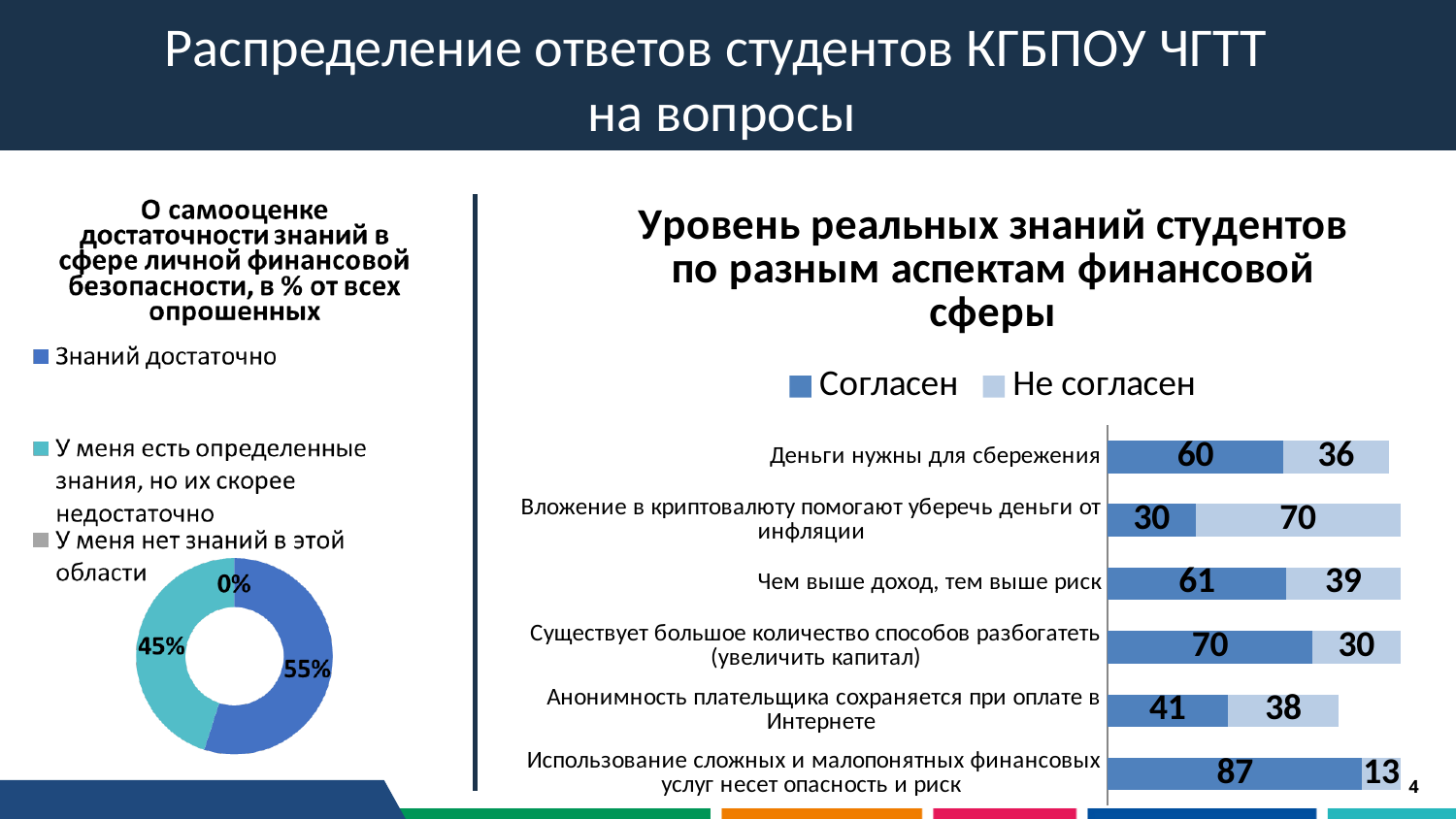
In the chart "Уровень реальных знаний студентов по разным аспектам финансовой сферы", which statement has the lowest "Согласен" value? Вложение в криптовалюту помогают уберечь деньги от инфляции In the chart "Уровень реальных знаний студентов по разным аспектам финансовой сферы", what is the difference between the "Согласен" and "Не согласен" values for "Деньги нужны для сбережения"? 24 How many series does the legend of the chart "Уровень реальных знаний студентов по разным аспектам финансовой сферы" list? 2 In the chart "Уровень реальных знаний студентов по разным аспектам финансовой сферы", what is the "Согласен" value for "Использование сложных и малопонятных финансовых услуг несет опасность и риск"? 87 In the donut chart on the left, what share of respondents answered "Знаний достаточно"? 55% In the donut chart on the left, what share of respondents answered "У меня нет знаний в этой области"? 0% What kind of chart is the chart on the left of the slide? Donut (pie) chart In the chart "Уровень реальных знаний студентов по разным аспектам финансовой сферы", which statement has the highest "Согласен" value? Использование сложных и малопонятных финансовых услуг несет опасность и риск In the donut chart on the left, which category has the largest share? Знаний достаточно How many statements (categories) are shown in the chart "Уровень реальных знаний студентов по разным аспектам финансовой сферы"? 6 In the chart "Уровень реальных знаний студентов по разным аспектам финансовой сферы", what is the "Не согласен" value for "Вложение в криптовалюту помогают уберечь деньги от инфляции"? 70 In the chart "Уровень реальных знаний студентов по разным аспектам финансовой сферы", what is the total of the stacked bar for "Анонимность плательщика сохраняется при оплате в Интернете"? 79